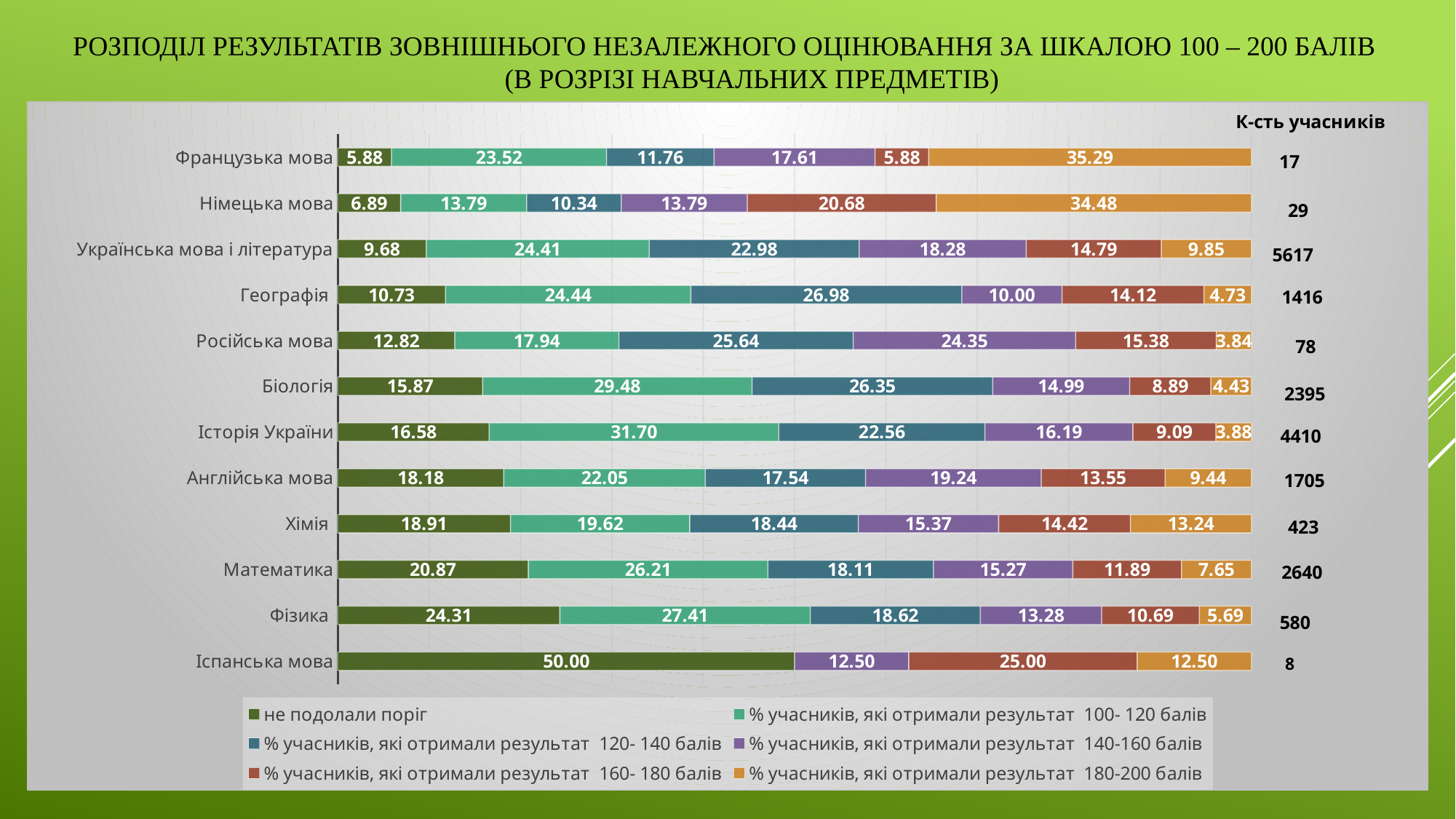
What is the value of the 120-140 балів segment for Географія? 26.98 Which subject has the highest value for 'не подолали поріг'? Іспанська мова For Фізика, what is the difference between the 100-120 балів value and the 120-140 балів value? 8.79 Which is larger: the 100-120 балів value for Біологія or for Історія України? Історія України How many series does the legend list? 6 What is the total of the stacked bar for Іспанська мова? 100.00 Which subject has the lowest value for 'не подолали поріг'? Французька мова What kind of chart is shown on the slide? stacked bar chart How many subjects (categories) are plotted on the chart? 12 Which subject has the highest value for the 140-160 балів segment? Російська мова What is the value of 'не подолали поріг' for Математика? 20.87 What percentage of participants in Французька мова received a result of 180-200 балів? 35.29